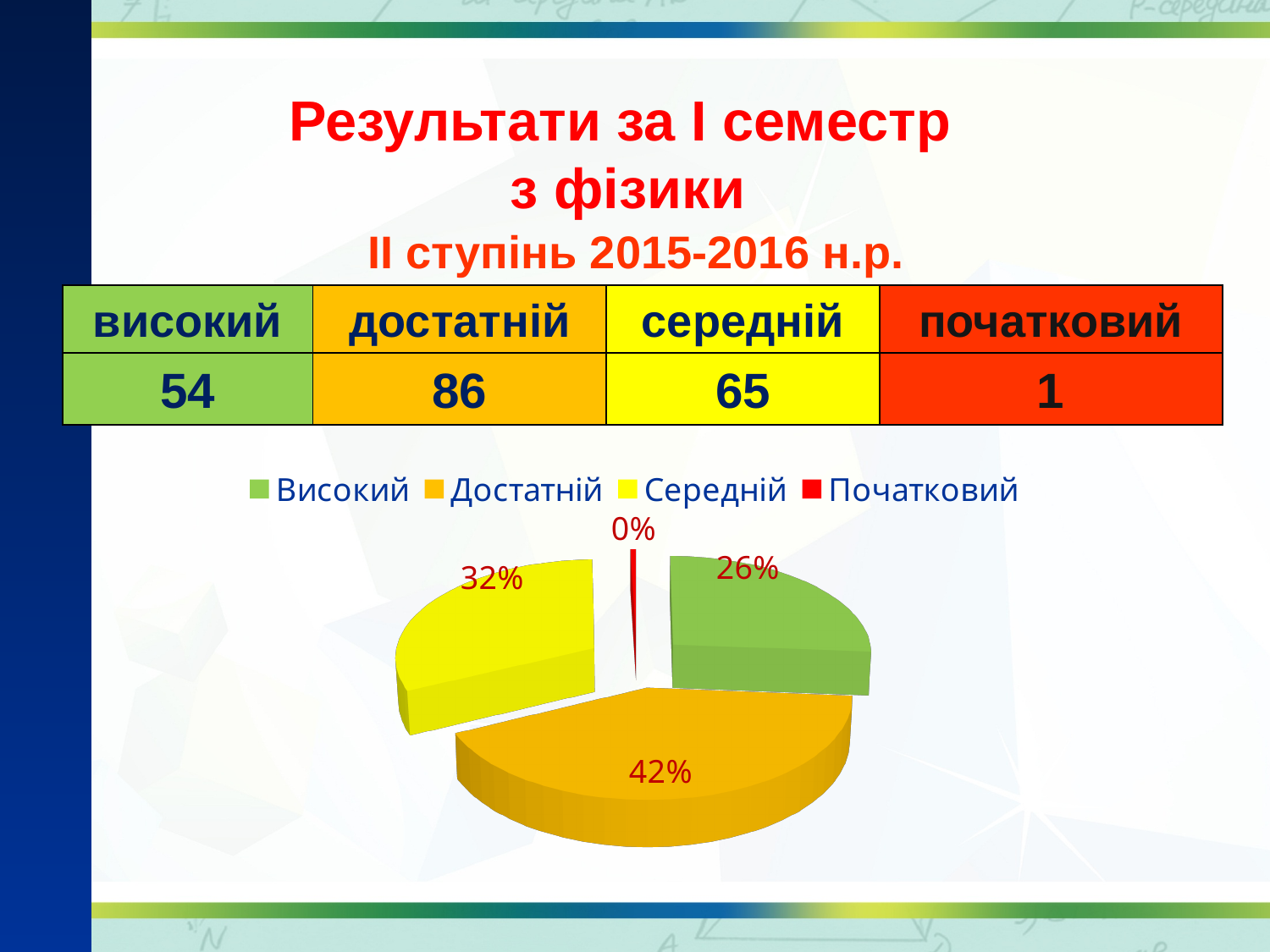
What is the difference in percentage points between the Достатній and Високий slices? 16 What colour is the Середній slice in the pie chart? yellow Which slice is larger in the pie chart, Середній or Високий? Середній What percentage share does the Початковий slice have in the pie chart? 0% What colour is the Достатній slice in the pie chart? orange What percentage share does the Середній slice have in the pie chart? 32% What kind of chart is shown on the slide? pie chart Which category has the smallest slice in the pie chart? Початковий What percentage share does the Високий slice have in the pie chart? 26% How many categories does the legend of the pie chart list? 4 Which category has the largest slice in the pie chart? Достатній